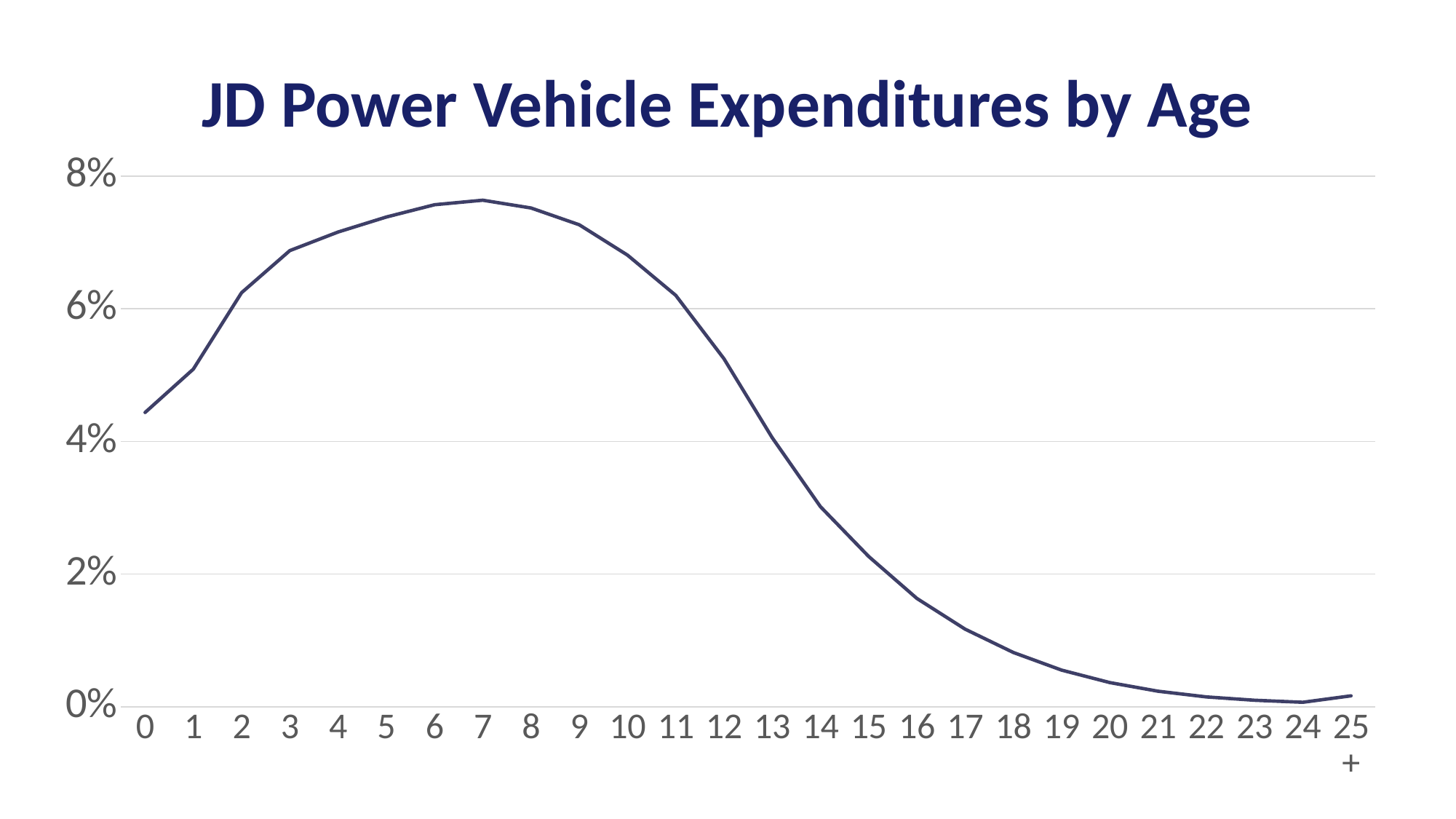
Is the value for age 16 greater or less than 2%? less Which is larger, the value for age 3 or the value for age 13? age 3 How many age categories are shown on the x axis? 26 What is the title of the chart? JD Power Vehicle Expenditures by Age Is the value for age 2 greater or less than 6%? greater Is the value for age 5 greater or less than 8%? less Which is larger, the value for age 9 or the value for age 15? age 9 What kind of chart is shown on the slide? line chart At which age does the line reach its highest value? 7 Do the values rise or fall from age 7 to age 24? fall